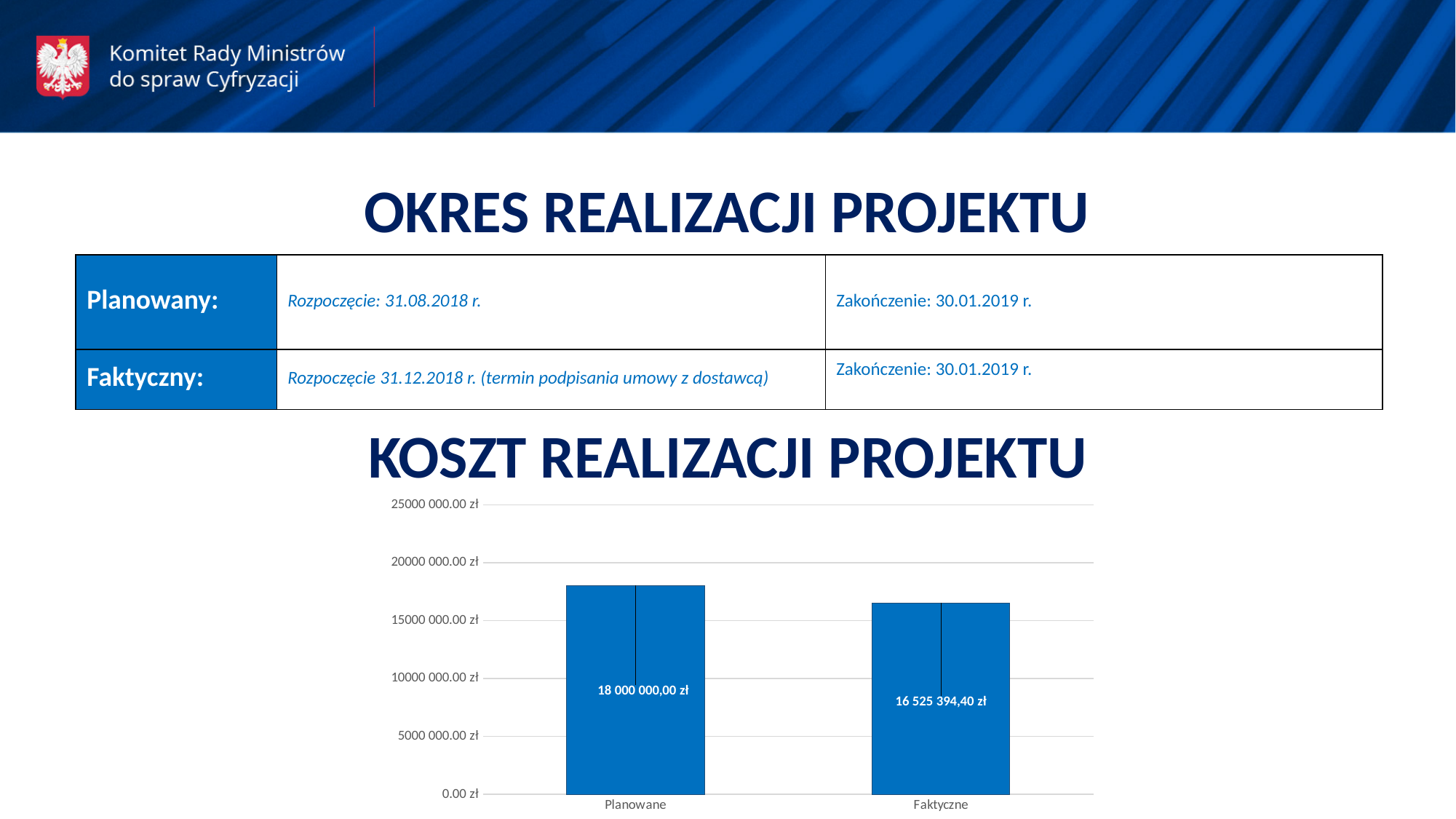
Which category has the lowest value in the chart? Faktyczne How many categories are shown in the chart? 2 Which category has the highest value in the chart? Planowane Do the values rise or fall from Planowane to Faktyczne? fall What is the value for Faktyczne in the chart? 16 525 394,40 zł What is the difference between the Planowane and Faktyczne values? 1 474 605,60 zł What is the title above the chart? KOSZT REALIZACJI PROJEKTU What is the value for Planowane in the chart? 18 000 000,00 zł What kind of chart is shown on the slide? bar chart Is the value for Planowane greater or less than 20000 000.00 zł? less Is the value for Faktyczne greater or less than 15000 000.00 zł? greater Which is larger, the value for Planowane or the value for Faktyczne? Planowane